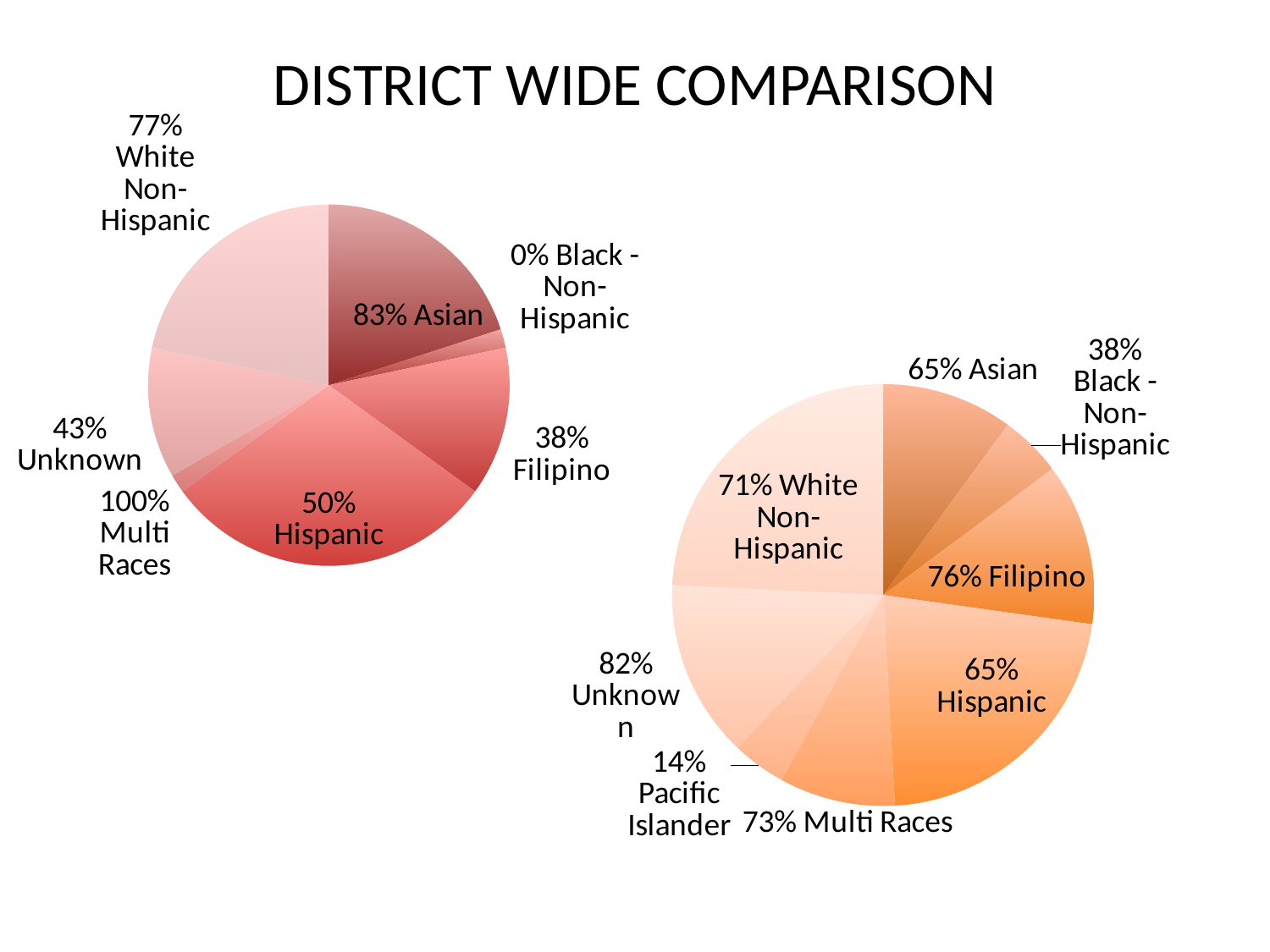
On the right pie chart, what value is shown for Filipino? 76% On the right pie chart, what value is shown for Pacific Islander? 14% On the left pie chart, which category has the highest labelled value? Multi Races On the right pie chart, which category has the lowest labelled value? Pacific Islander On the left pie chart, what value is shown for Unknown? 43% On the left pie chart, which has the larger labelled value, Asian or White Non-Hispanic? Asian On the left pie chart, which category has the lowest labelled value? Black - Non-Hispanic On the left pie chart, what value is shown for Asian? 83% On the right pie chart, what is the difference between the labelled values for Filipino and Black - Non-Hispanic? 38 percentage points How many categories are labelled on the right pie chart? 8 What kind of chart is used on the left side of the slide? Pie chart On the right pie chart, which category has the highest labelled value? Unknown